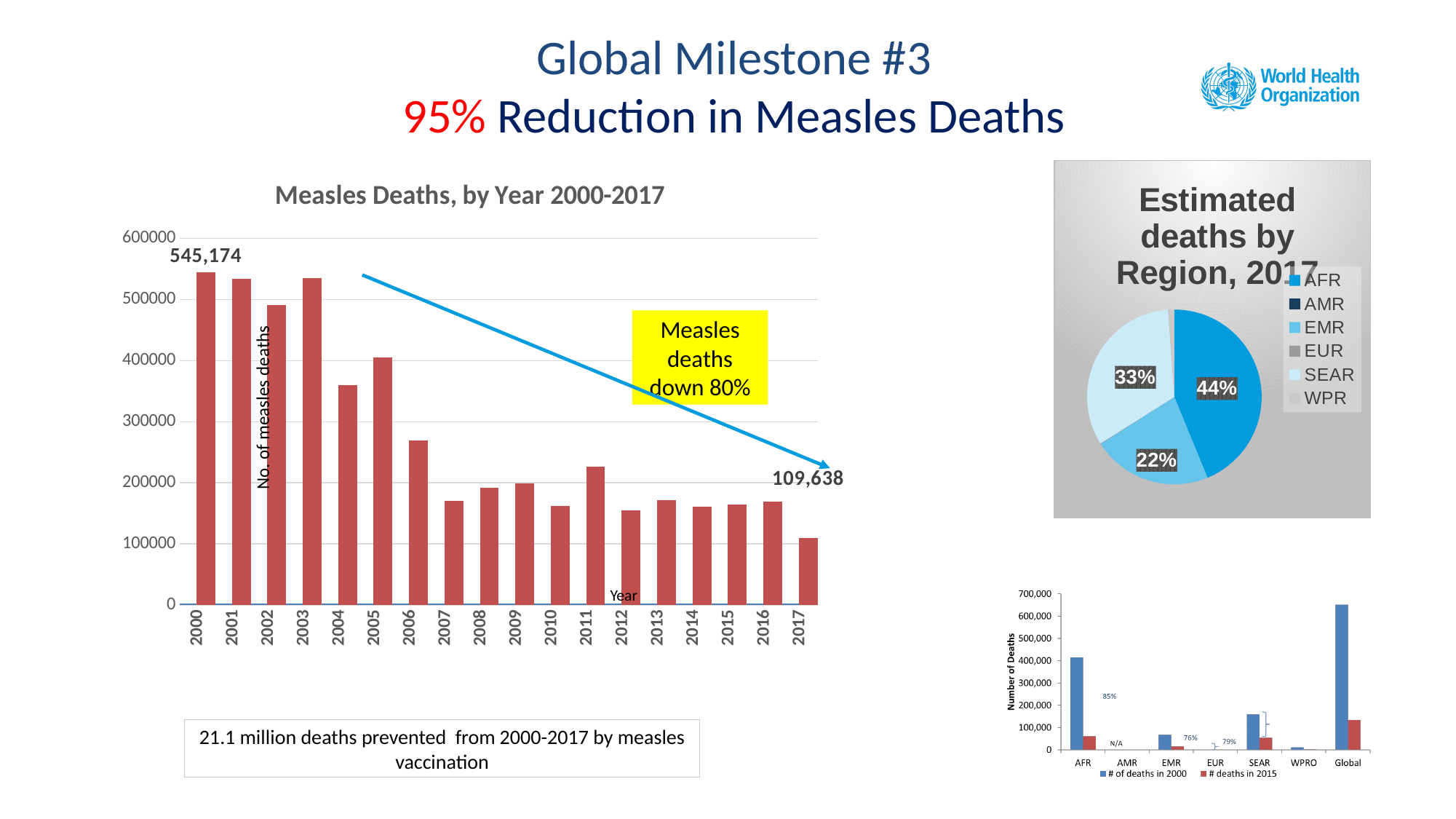
In the bar chart at the bottom right of the slide, how many series does the legend list? 2 How many regions does the legend of the 'Estimated deaths by Region, 2017' pie chart list? 6 In the 'Measles Deaths, by Year 2000-2017' chart, what is the number of measles deaths in 2000? 545,174 In the 'Measles Deaths, by Year 2000-2017' chart, which year has the lowest number of measles deaths? 2017 In the 'Measles Deaths, by Year 2000-2017' chart, how many years (bars) are plotted? 18 In the 'Measles Deaths, by Year 2000-2017' chart, is the value for 2004 greater or less than 400000? less In the 'Measles Deaths, by Year 2000-2017' chart, which year has the highest number of measles deaths? 2000 In the bar chart at the bottom right of the slide, is the '# of deaths in 2000' value for Global greater or less than 600,000? greater In the 'Estimated deaths by Region, 2017' pie chart, what share of deaths is attributed to AFR? 44% In the 'Measles Deaths, by Year 2000-2017' chart, what is the number of measles deaths in 2017? 109,638 In the 'Measles Deaths, by Year 2000-2017' chart, do measles deaths generally rise or fall from 2000 to 2017? fall In the 'Estimated deaths by Region, 2017' pie chart, what is the difference in percentage points between the AFR slice and the SEAR slice? 11 percentage points